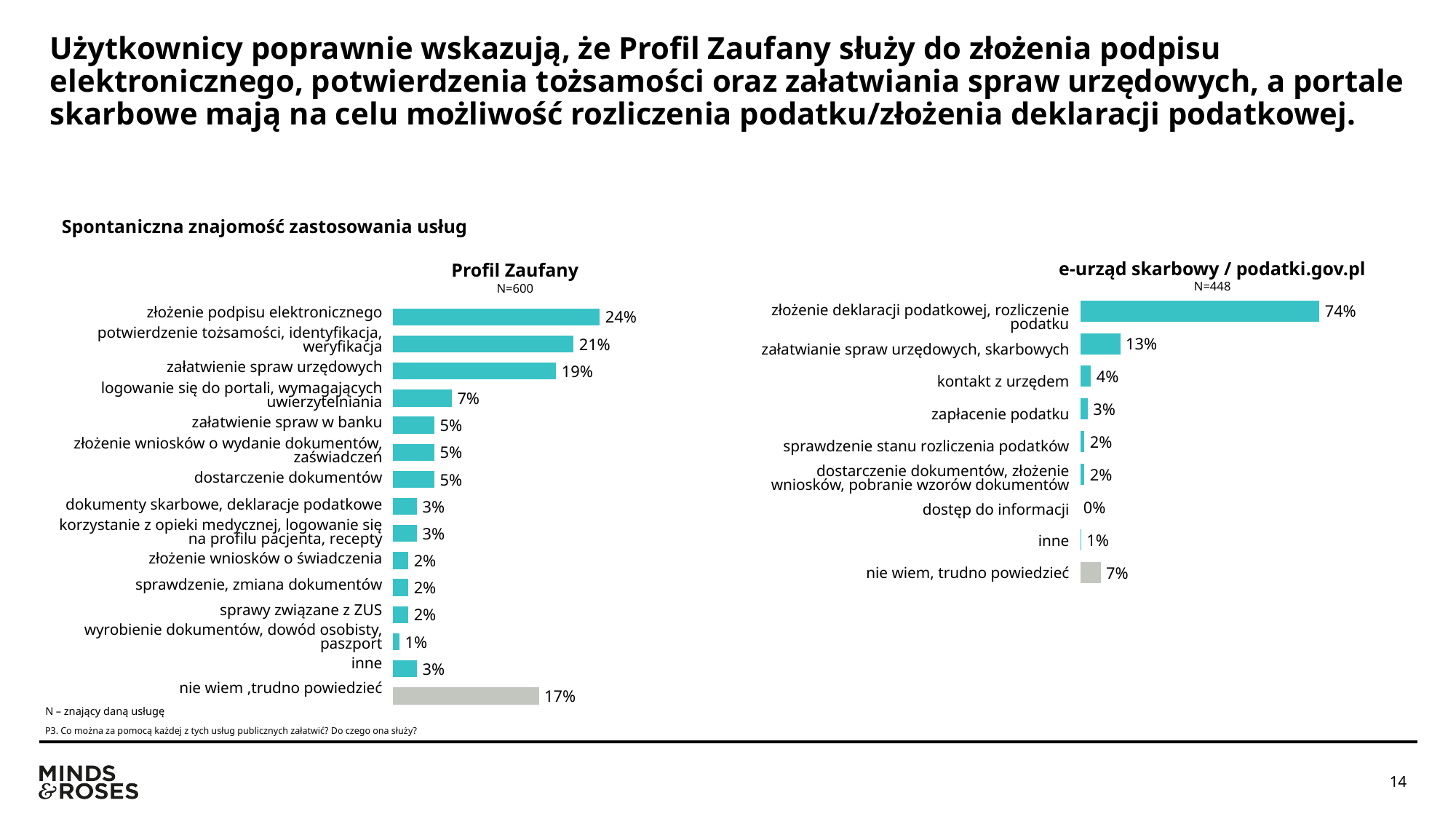
In the "Profil Zaufany" chart, what is the value for "załatwienie spraw urzędowych"? 19% In the "e-urząd skarbowy / podatki.gov.pl" chart, what is the value for "załatwianie spraw urzędowych, skarbowych"? 13% How many categories are shown in the "Profil Zaufany" chart? 15 In the "Profil Zaufany" chart, what is the difference between "złożenie podpisu elektronicznego" and "potwierdzenie tożsamości, identyfikacja, weryfikacja"? 3% How many categories are shown in the "e-urząd skarbowy / podatki.gov.pl" chart? 9 In the "e-urząd skarbowy / podatki.gov.pl" chart, which category has the lowest value? dostęp do informacji In the "Profil Zaufany" chart, what is the value for "złożenie podpisu elektronicznego"? 24% In the "e-urząd skarbowy / podatki.gov.pl" chart, what is the difference between "złożenie deklaracji podatkowej, rozliczenie podatku" and "nie wiem, trudno powiedzieć"? 67% What type of chart is the "Profil Zaufany" chart? Bar chart In the "Profil Zaufany" chart, which is larger: "logowanie się do portali, wymagających uwierzytelniania" or "załatwienie spraw w banku"? logowanie się do portali, wymagających uwierzytelniania In the "e-urząd skarbowy / podatki.gov.pl" chart, which category has the highest value? złożenie deklaracji podatkowej, rozliczenie podatku What sample size (N) is shown for the "e-urząd skarbowy / podatki.gov.pl" chart? N=448